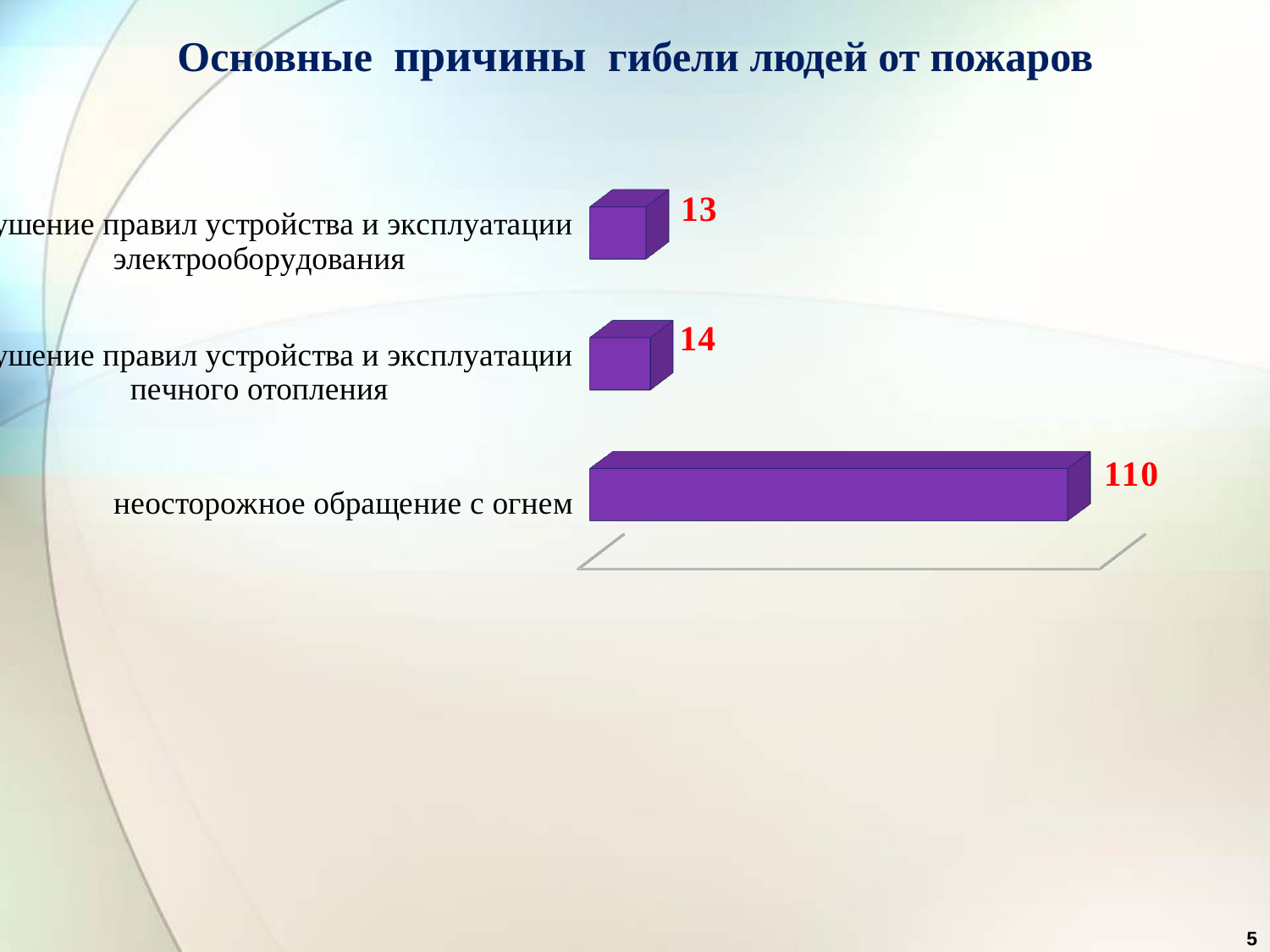
What value is shown for the bar about rules for electrical equipment (электрооборудования)? 13 What kind of chart is shown on the slide? Bar chart Which is larger: the value for "неосторожное обращение с огнем" or the value for the electrical equipment (электрооборудования) category? неосторожное обращение с огнем How many categories are shown in the chart? 3 What value is shown for the bar labelled "неосторожное обращение с огнем"? 110 What is the difference between the value for the stove heating (печного отопления) category and the electrical equipment (электрооборудования) category? 1 What is the title of the slide? Основные причины гибели людей от пожаров Which category has the highest value? неосторожное обращение с огнем Which category has the lowest value? нарушение правил устройства и эксплуатации электрооборудования What is the difference between the value for "неосторожное обращение с огнем" and the value for the stove heating (печного отопления) category? 96 What value is shown for the bar about rules for stove heating (печного отопления)? 14 What colour are the bars in the chart? Purple